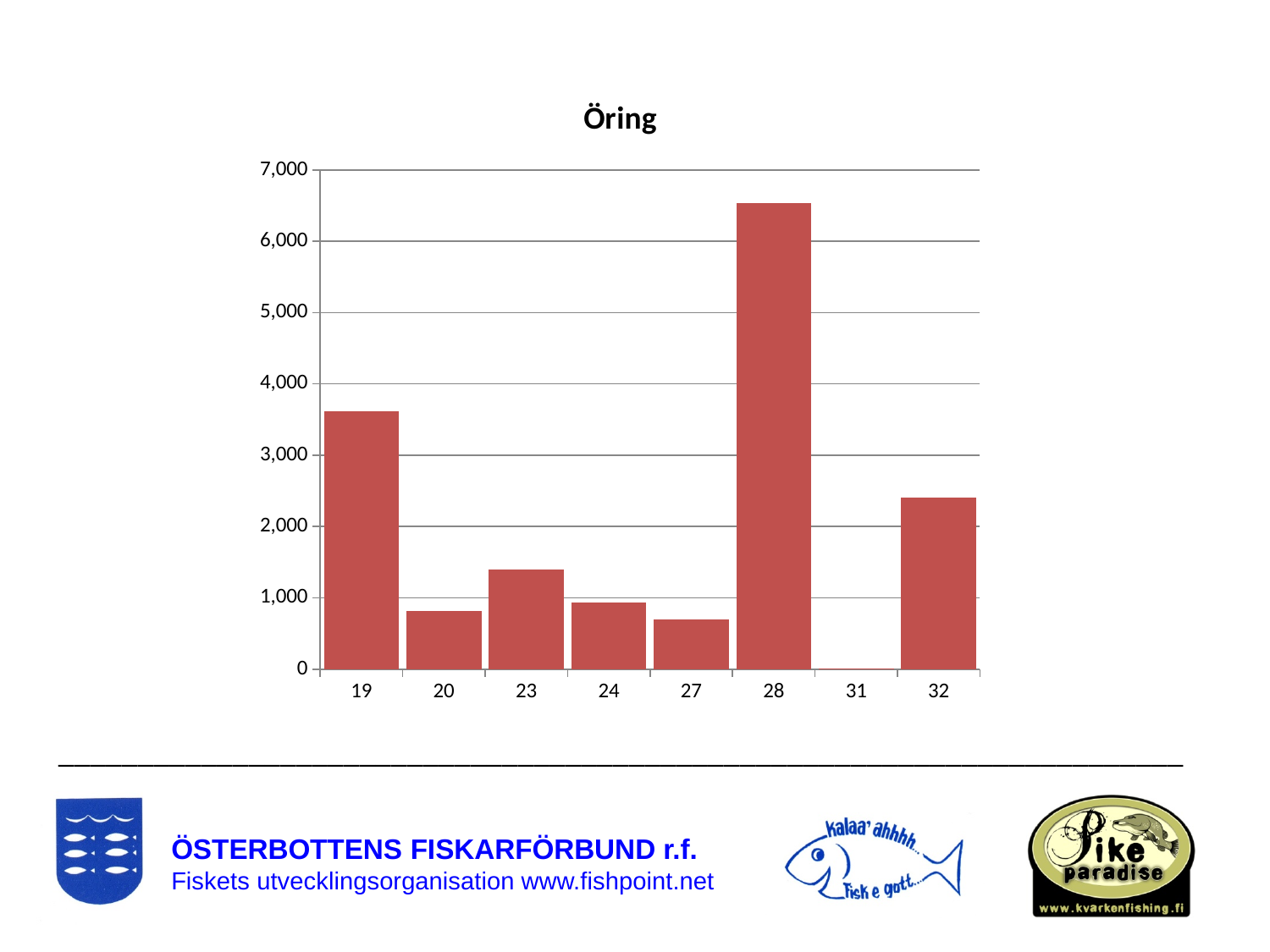
Is the value for category 32 greater or less than 2,000? greater Which has a larger value, category 19 or category 32? 19 Is the value for category 27 greater or less than 1,000? less Is the value for category 20 greater or less than 1,000? less Which has a larger value, category 23 or category 24? 23 What is the title of the chart? Öring How many categories are shown on the x axis of the chart? 8 What kind of chart is shown on the slide? bar chart Which category has the lowest value in the chart? 31 Which category has the highest value in the chart? 28